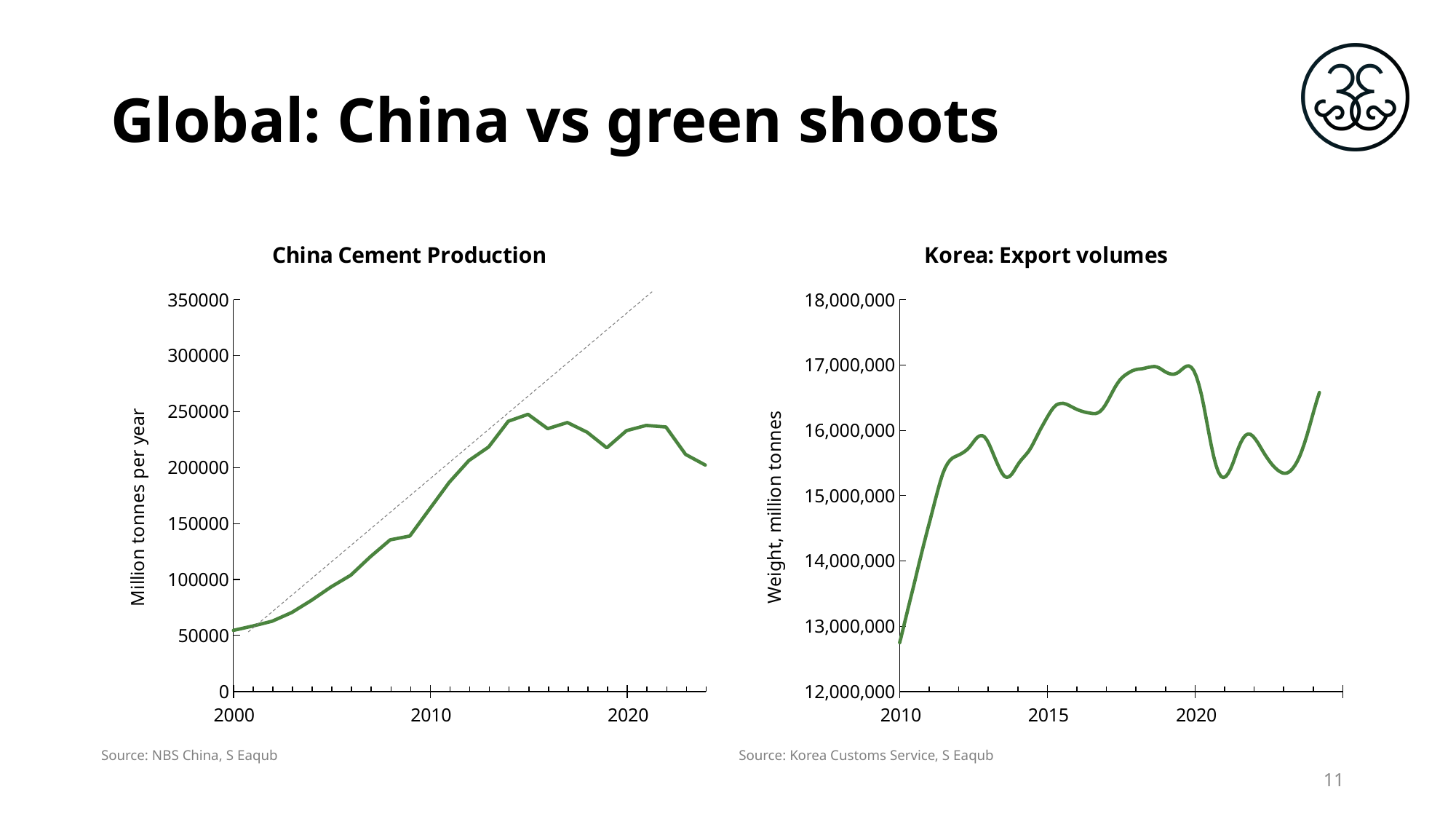
In the China Cement Production chart, is the value for 2010 greater or less than 150000? greater In the China Cement Production chart, is the value for 2015 greater or less than 200000? greater What is the y-axis label of the Korea: Export volumes chart? Weight, million tonnes In the China Cement Production chart, do values rise or fall between 2000 and 2010? rise What kind of chart is the China Cement Production chart? line chart In the Korea: Export volumes chart, is the value for 2018 greater or less than 16,000,000? greater What kind of chart is the Korea: Export volumes chart? line chart What is the y-axis label of the China Cement Production chart? Million tonnes per year In the Korea: Export volumes chart, do values rise or fall between 2010 and 2012? rise